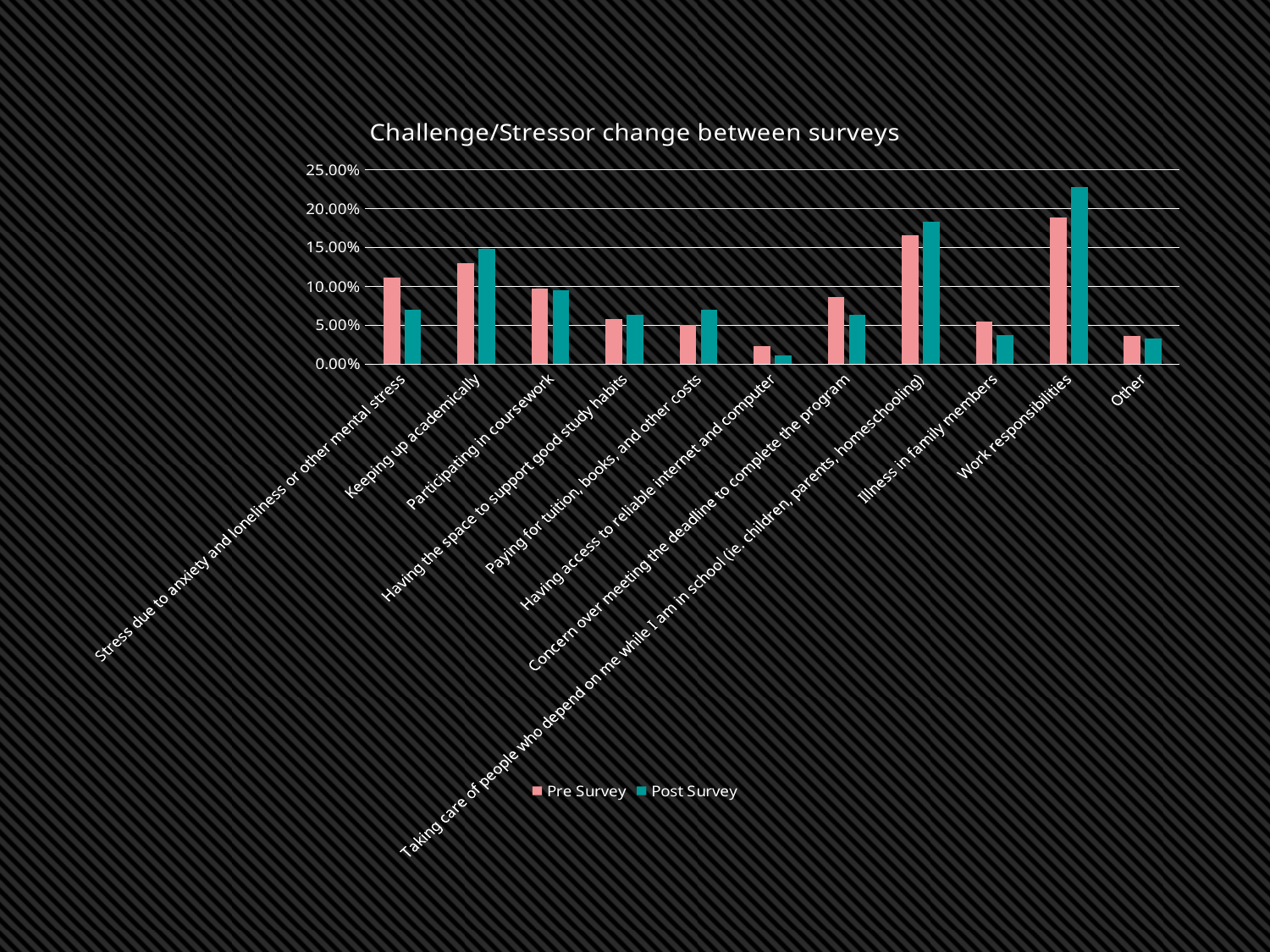
What is the title of the chart? Challenge/Stressor change between surveys How many categories are shown on the x axis? 11 For Keeping up academically, which is larger, the Pre Survey or Post Survey value? Post Survey For Stress due to anxiety and loneliness or other mental stress, which is larger, the Pre Survey or Post Survey value? Pre Survey Is the Post Survey value for Stress due to anxiety and loneliness or other mental stress greater or less than 10.00%? less Which category has the highest Pre Survey value? Work responsibilities Is the Post Survey value for Work responsibilities greater or less than 20.00%? greater How many series does the legend list? 2 Which category has the lowest Post Survey value? Having access to reliable internet and computer What kind of chart is shown on the slide? bar chart Which category has the highest Post Survey value? Work responsibilities Is the Pre Survey value for Work responsibilities greater or less than 20.00%? less